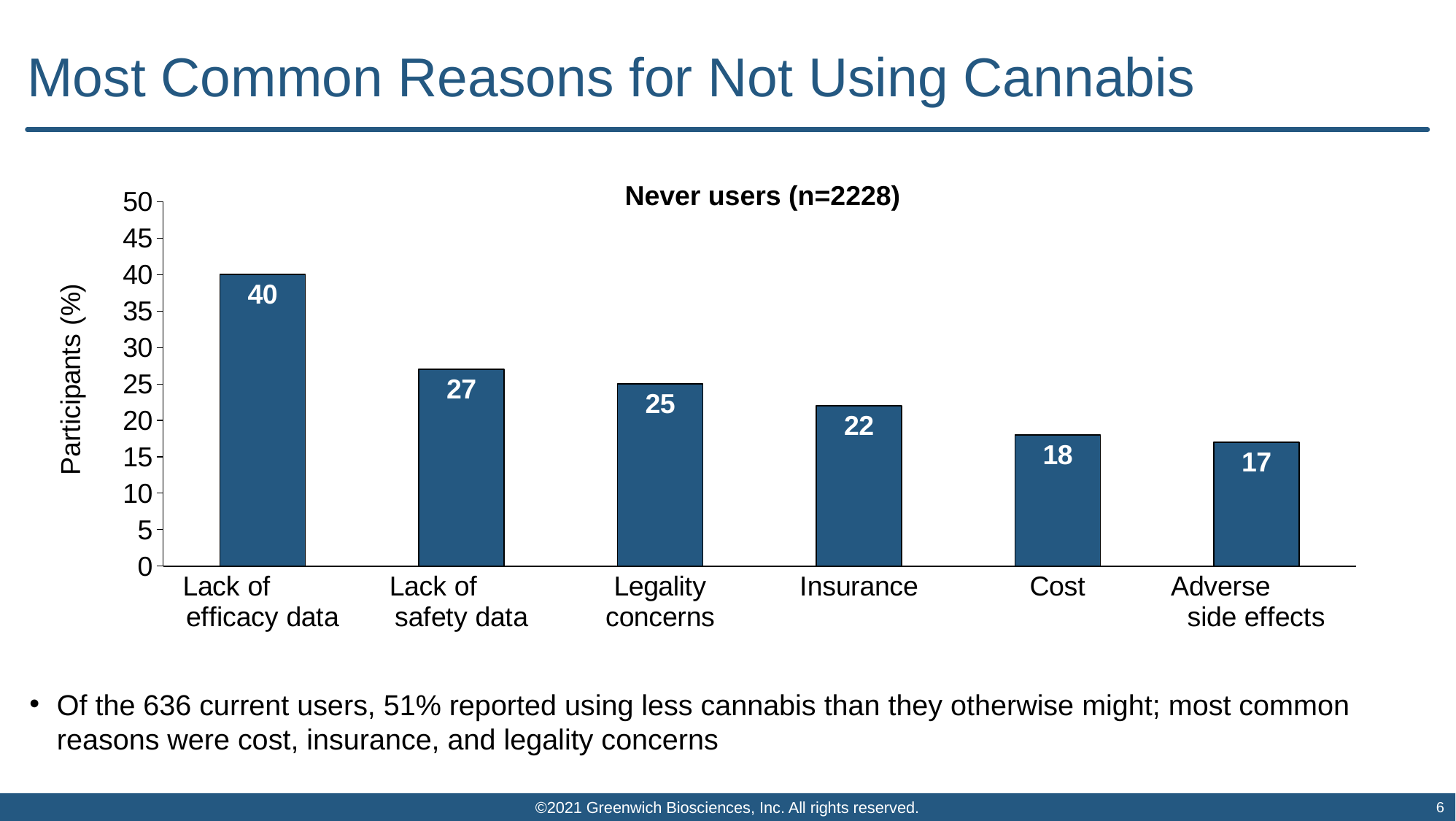
Which is larger, the value for Lack of safety data or the value for Legality concerns? Lack of safety data Do the values rise or fall from left to right across the categories? Fall What is the title shown above the chart? Never users (n=2228) What is the difference between the values for Legality concerns and Cost? 7 What percentage of never users cited lack of efficacy data as a reason for not using cannabis? 40 What is the difference between the values for Lack of efficacy data and Lack of safety data? 13 What kind of chart is shown on the slide? Bar chart Which reason has the lowest percentage of participants? Adverse side effects What is the value for Insurance in the chart? 22 Which reason has the highest percentage of participants? Lack of efficacy data How many reasons (categories) are shown in the chart? 6 What is the value for Adverse side effects? 17